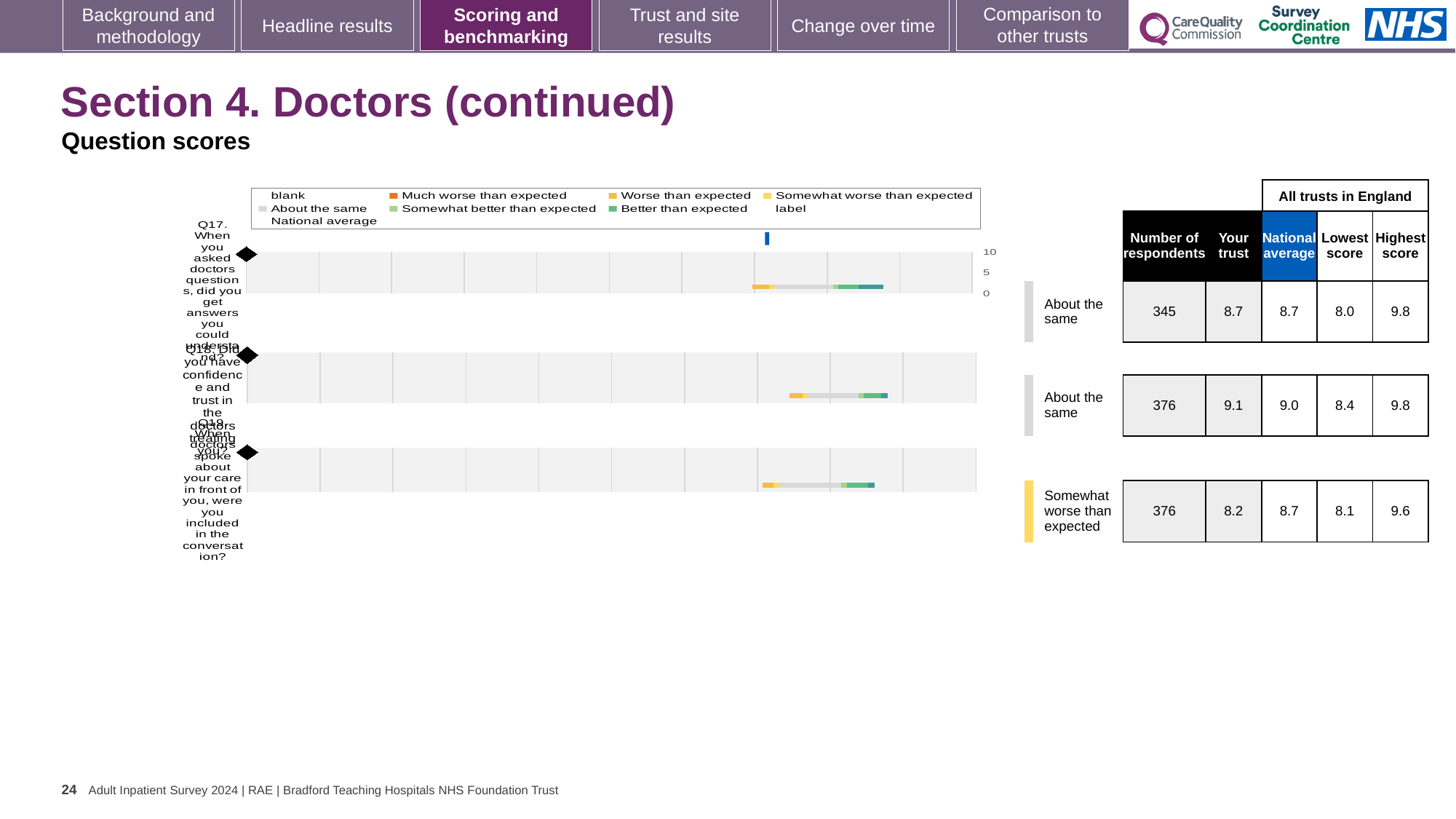
Which question has the highest 'Your trust' score? Q18 What is the highest score among all trusts in England for Q19? 9.6 Which question has the lowest 'Your trust' score? Q19 How many respondents answered Q17? 345 What is the 'Your trust' score for Q18 (confidence and trust in the doctors treating you)? 9.1 What is the difference between the 'Your trust' scores for Q18 and Q19? 0.9 For Q18, which is larger: the 'Your trust' score or the national average? Your trust What is the national average score for Q19 (included in the conversation when doctors spoke about your care)? 8.7 What kind of chart is shown on the slide? bar chart What is the lowest score among all trusts in England for Q18? 8.4 How many questions (categories) are plotted in the chart? 3 Which benchmark category is Q19 assigned to? Somewhat worse than expected